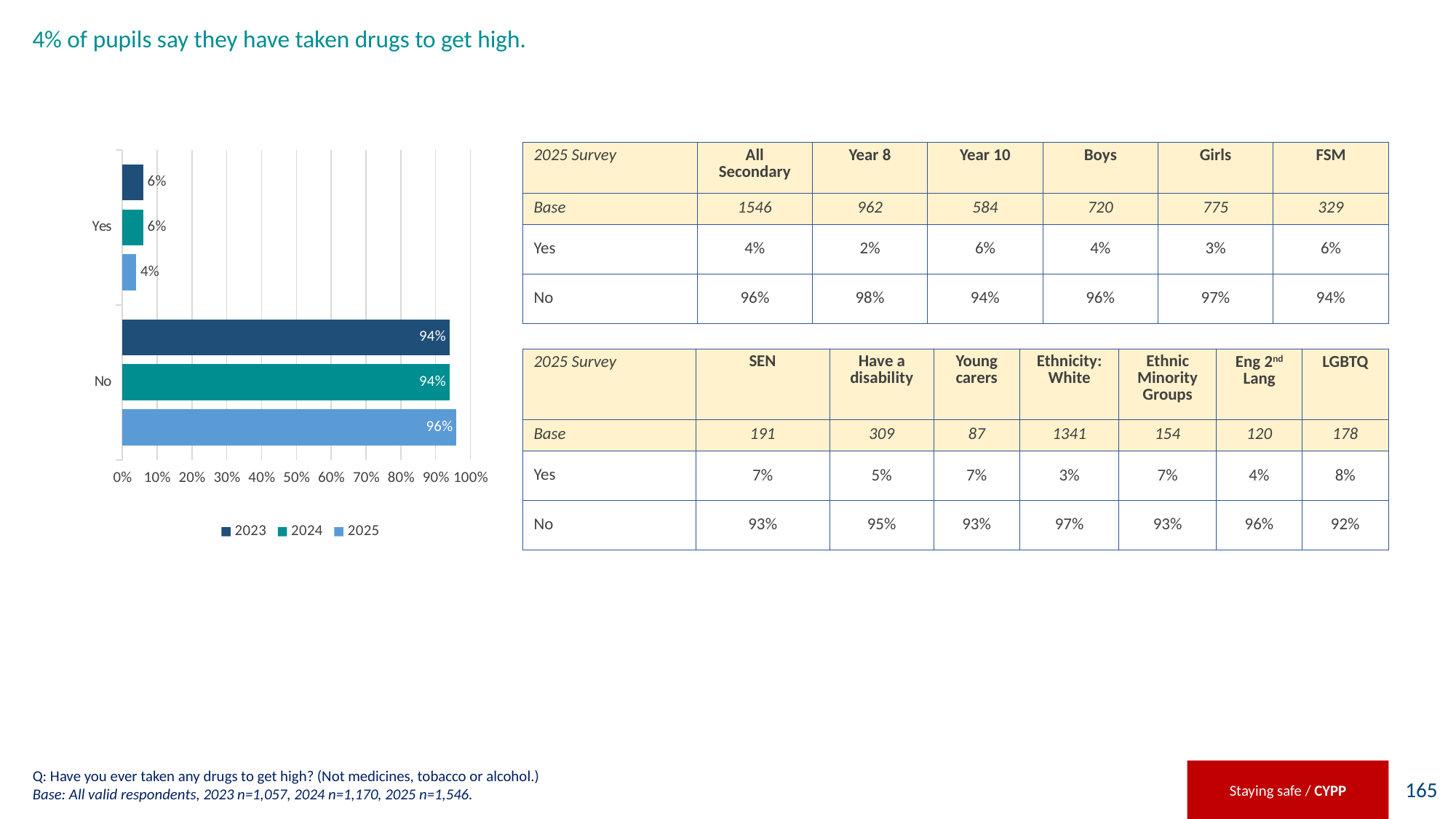
How many categories are shown on the chart? 2 What is the value for 'Yes' in the 2024 series? 6% What kind of chart is shown on the slide? Bar chart What is the difference between the 'No' value for 2025 and the 'No' value for 2024? 2% What is the difference between the 'Yes' value for 2023 and the 'Yes' value for 2025? 2% How many series does the legend list? 3 What is the value for 'Yes' in the 2025 series? 4% Which is larger: the 'Yes' value for 2023 or the 'Yes' value for 2025? 2023 Which series has the lowest value for 'Yes'? 2025 Which series has the highest value for 'No'? 2025 What is the value for 'No' in the 2025 series? 96% What is the value for 'No' in the 2023 series? 94%